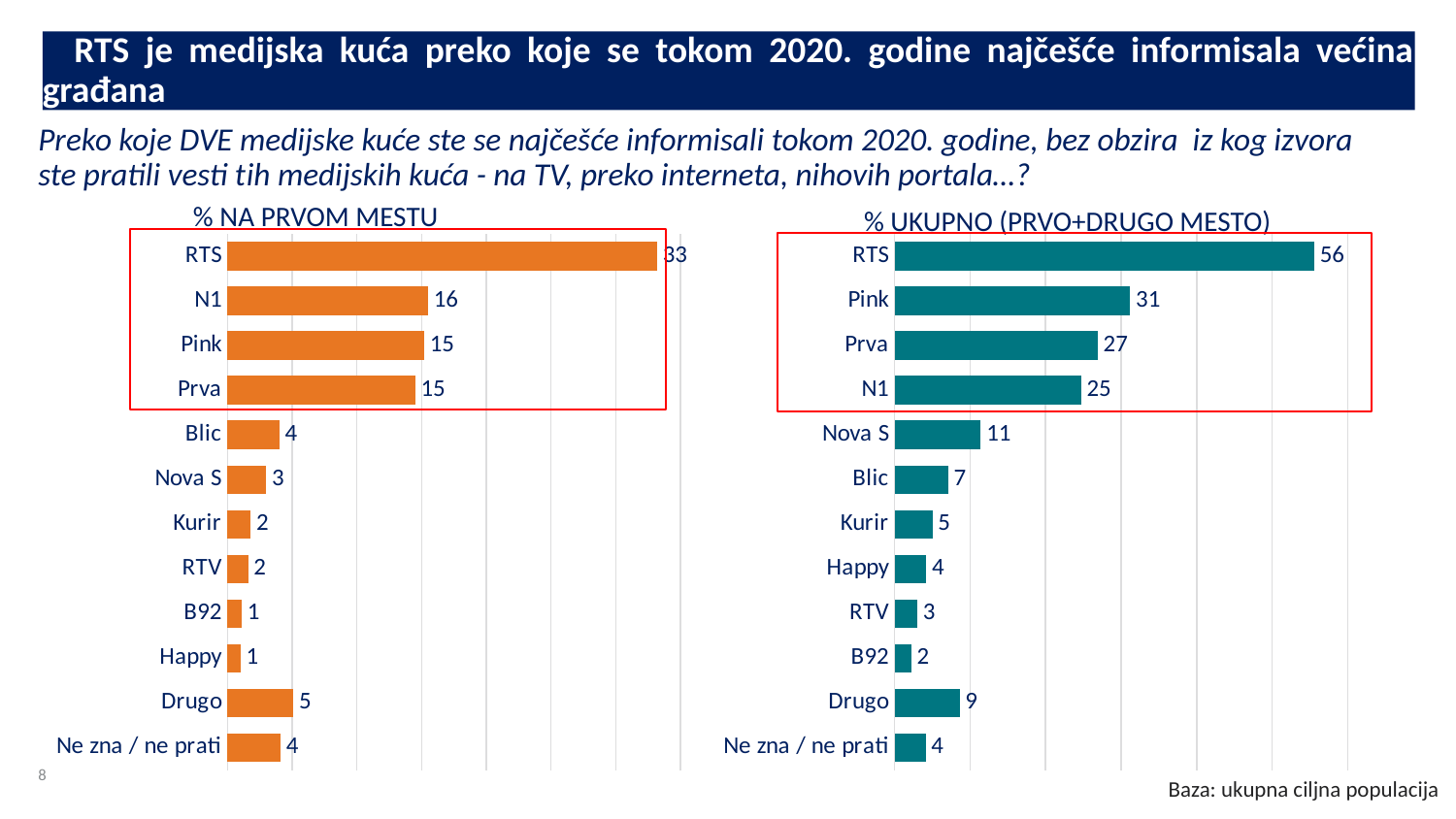
In the '% UKUPNO (PRVO+DRUGO MESTO)' chart, what is the value for Kurir? 5 What kind of chart is the '% UKUPNO (PRVO+DRUGO MESTO)' chart? Bar chart In the '% NA PRVOM MESTU' chart, what is the value for RTS? 33 In the '% UKUPNO (PRVO+DRUGO MESTO)' chart, what is the value for Pink? 31 In the '% NA PRVOM MESTU' chart, which categories have the lowest value? B92 and Happy In the '% UKUPNO (PRVO+DRUGO MESTO)' chart, what is the difference between Prva and N1? 2 In the '% UKUPNO (PRVO+DRUGO MESTO)' chart, which category has the highest value? RTS In the '% NA PRVOM MESTU' chart, what is the difference between RTS and N1? 17 How many categories are shown in the '% NA PRVOM MESTU' chart? 12 What colour are the bars in the '% NA PRVOM MESTU' chart? Orange In the '% UKUPNO (PRVO+DRUGO MESTO)' chart, which is larger, Nova S or Blic? Nova S In the '% NA PRVOM MESTU' chart, which is larger, Blic or Drugo? Drugo